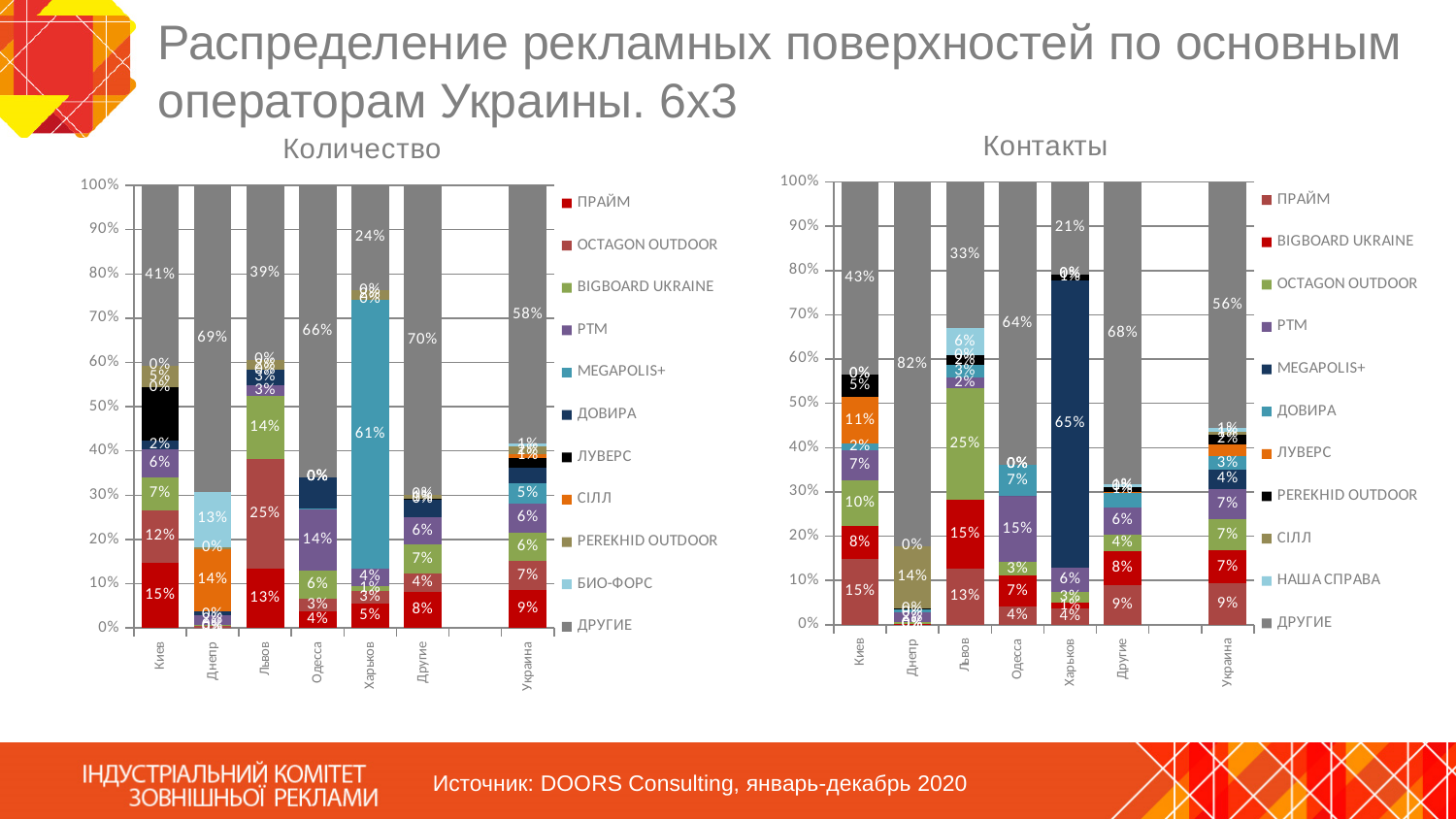
In the "Контакты" chart, what is the value for ЛУВЕРС in Киев? 11% How many categories are shown on the x axis of the "Количество" chart? 7 In the "Количество" chart, what is the value for ПРАЙМ in Киев? 15% In the "Контакты" chart, which city has the highest value for ДРУГИЕ? Днепр In the "Количество" chart, what is the difference between the ДРУГИЕ values for Днепр and Киев? 28% In the "Контакты" chart, what is the value for ДРУГИЕ in Днепр? 82% How many series does the legend of the "Контакты" chart list? 11 In the "Контакты" chart, which is larger for Львов: OCTAGON OUTDOOR or BIGBOARD UKRAINE? OCTAGON OUTDOOR What kind of chart is the "Количество" chart? Stacked bar chart In the "Количество" chart, which category has the lowest value for ДРУГИЕ? Харьков In the "Контакты" chart, what is the value for MEGAPOLIS+ in Харьков? 65% In the "Количество" chart, what is the value for MEGAPOLIS+ in Харьков? 61%